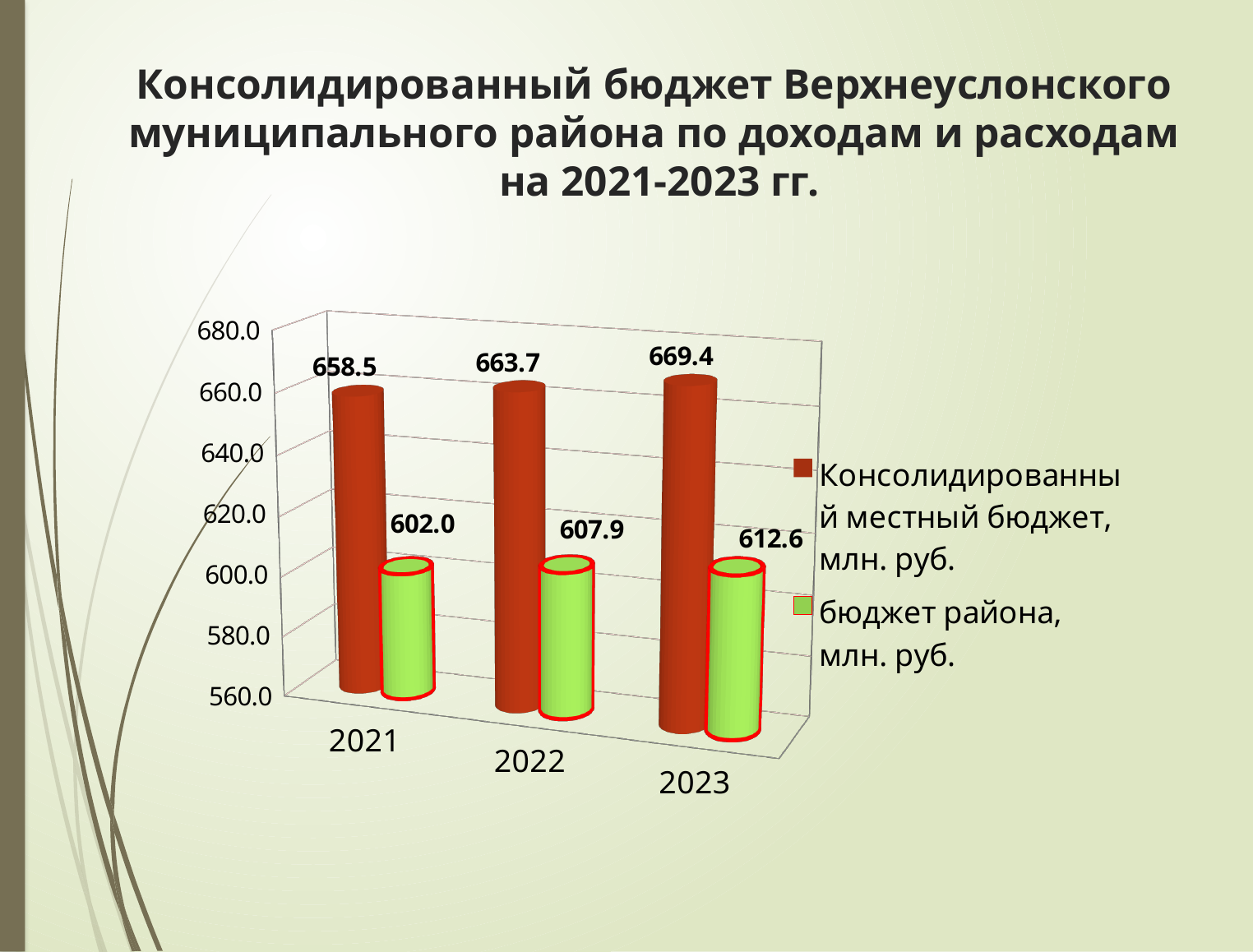
What is the difference between the consolidated local budget in 2022 and in 2021? 5.2 In which year is the district budget lowest? 2021 Does the district budget rise or fall from 2021 to 2023? Rise What is the value of the consolidated local budget (Консолидированный местный бюджет) for 2021? 658.5 What is the value of the district budget (бюджет района) for 2022? 607.9 What kind of chart is shown on the slide? Bar chart How many series does the legend list? 2 What is the difference between the consolidated local budget and the district budget in 2023? 56.8 Which is larger in 2022: the consolidated local budget or the district budget? Консолидированный местный бюджет In which year is the consolidated local budget highest? 2023 What is the value of the district budget (бюджет района) for 2023? 612.6 How many years are shown on the x axis? 3